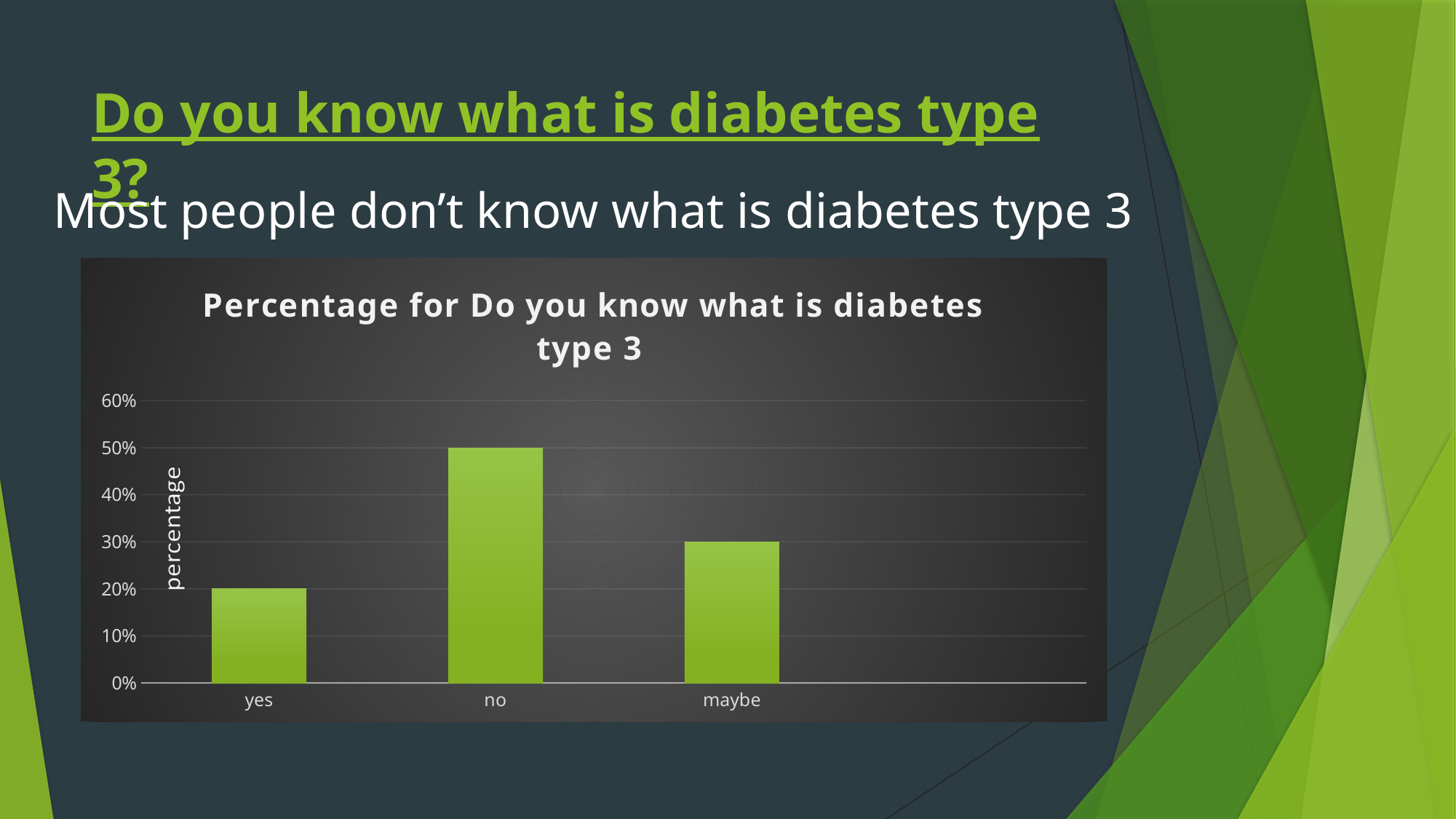
Which category has the highest value? no Which category has the lowest value? yes How many categories are shown on the x axis? 3 What is the value for "yes" in the chart? 20% Which is larger, the value for "maybe" or the value for "yes"? maybe What is the difference between the values for "no" and "yes"? 30% What kind of chart is shown on the slide? bar chart Is the value for "no" greater or less than 40%? greater What is the value for "no" in the chart? 50% What is the value for "maybe" in the chart? 30% What is the label of the vertical axis? percentage What is the difference between the values for "maybe" and "yes"? 10%